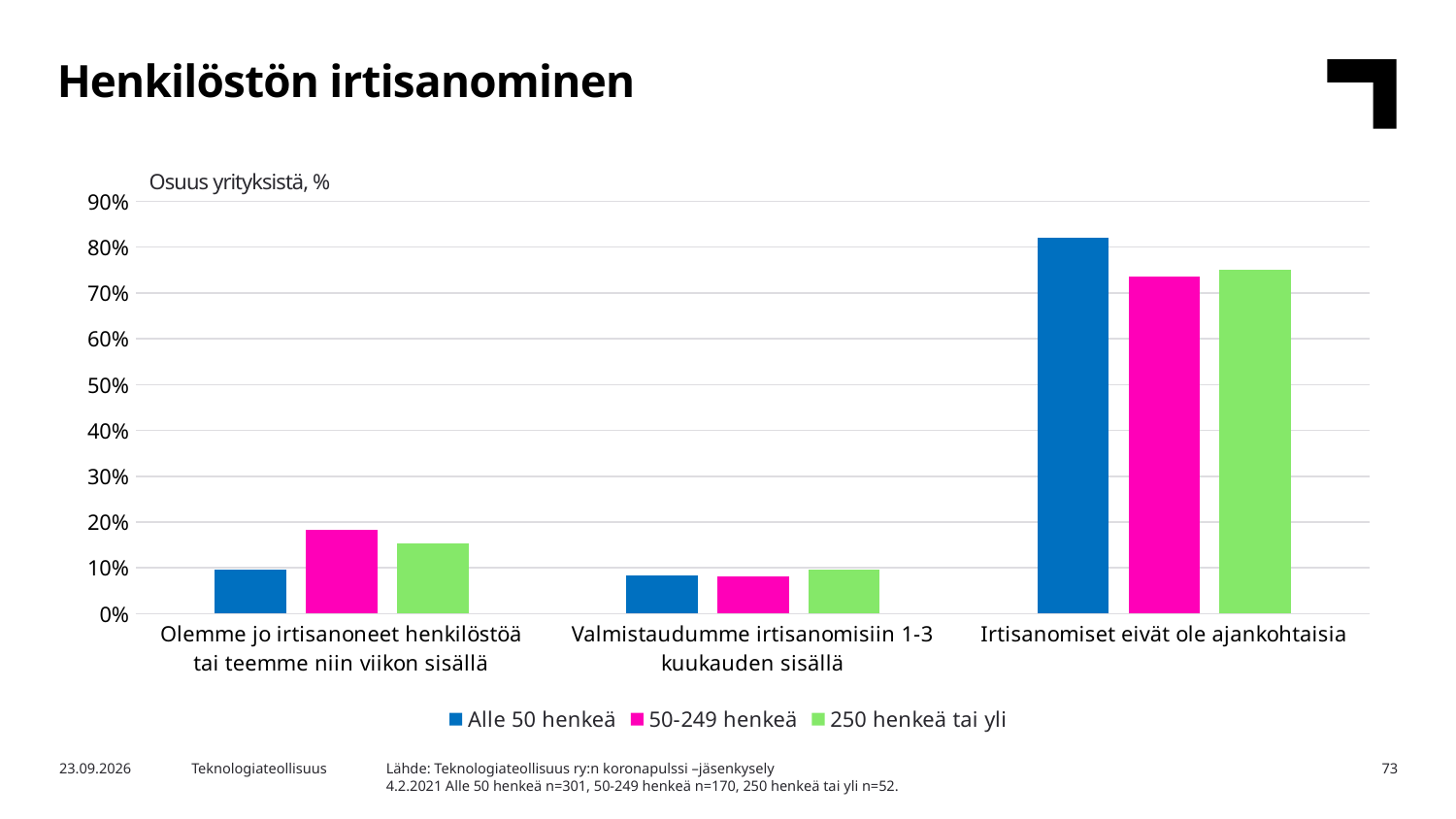
Within the category 'Irtisanomiset eivät ole ajankohtaisia', which series has the highest value? Alle 50 henkeä In the category 'Olemme jo irtisanoneet henkilöstöä tai teemme niin viikon sisällä', is the value for '250 henkeä tai yli' greater or less than 10%? greater In the category 'Irtisanomiset eivät ole ajankohtaisia', is the value for '50-249 henkeä' greater or less than 80%? less Which category has the highest bar for the 'Alle 50 henkeä' series? Irtisanomiset eivät ole ajankohtaisia In the category 'Irtisanomiset eivät ole ajankohtaisia', which is larger: the value for 'Alle 50 henkeä' or for '50-249 henkeä'? Alle 50 henkeä How many series does the legend list? 3 How many categories are shown on the x axis? 3 In the category 'Irtisanomiset eivät ole ajankohtaisia', is the value for 'Alle 50 henkeä' greater or less than 70%? greater What is the label shown above the vertical axis of the chart? Osuus yrityksistä, % What kind of chart is shown on the slide? bar chart Within the category 'Olemme jo irtisanoneet henkilöstöä tai teemme niin viikon sisällä', which series has the lowest value? Alle 50 henkeä Within the category 'Olemme jo irtisanoneet henkilöstöä tai teemme niin viikon sisällä', which series has the highest value? 50-249 henkeä